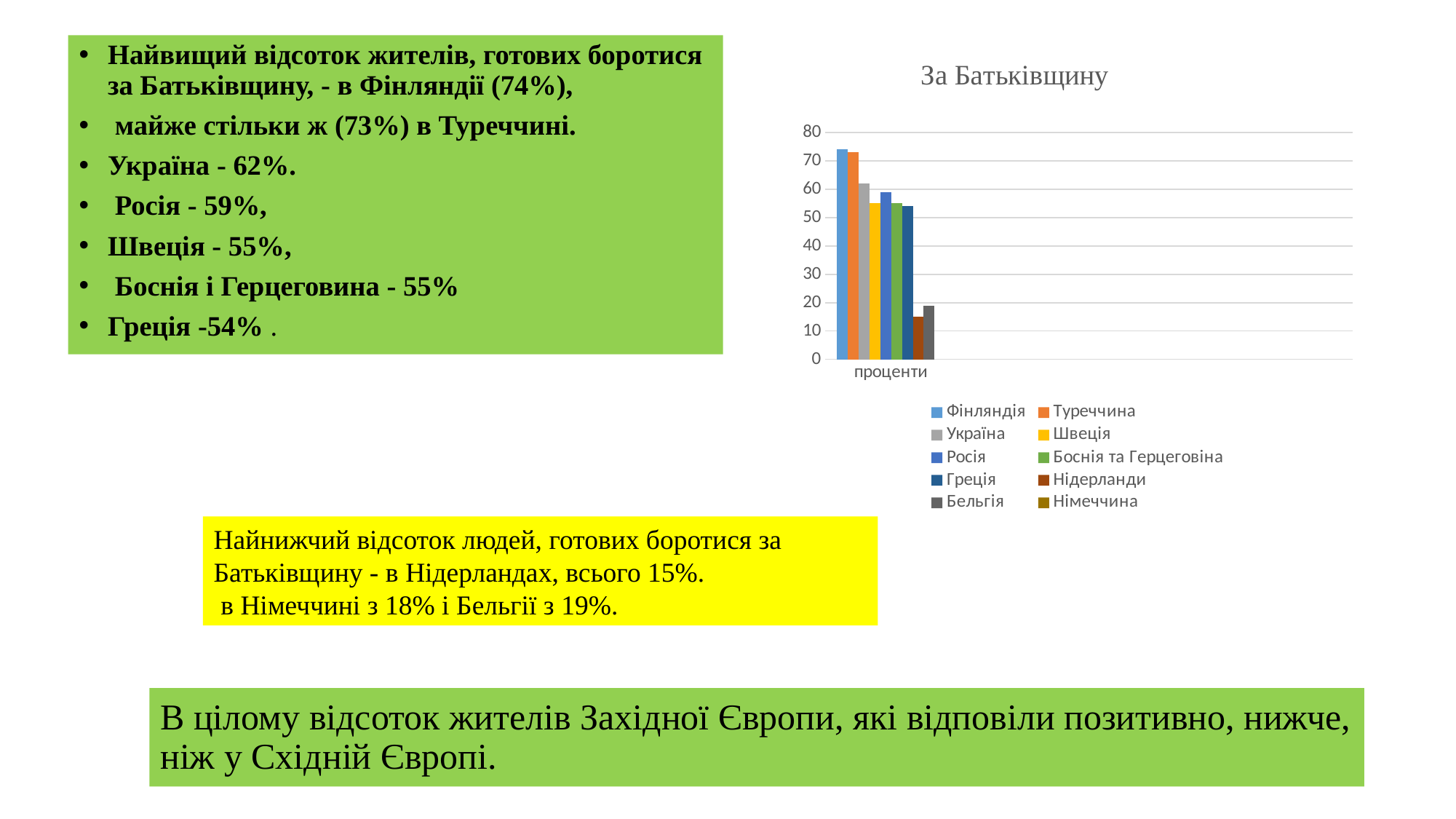
What label is shown on the x axis under the bars? проценти What kind of chart is shown on the slide? bar chart Is the value for Нідерланди greater or less than 20? less Which is larger, the value for Фінляндія or the value for Нідерланди? Фінляндія Is the value for Швеція greater or less than 50? greater Is the value for Бельгія greater or less than 10? greater What is the title of the chart? За Батьківщину Which series has the lowest bar in the chart? Нідерланди Which is larger, the value for Україна or the value for Росія? Україна How many series does the chart legend list? 10